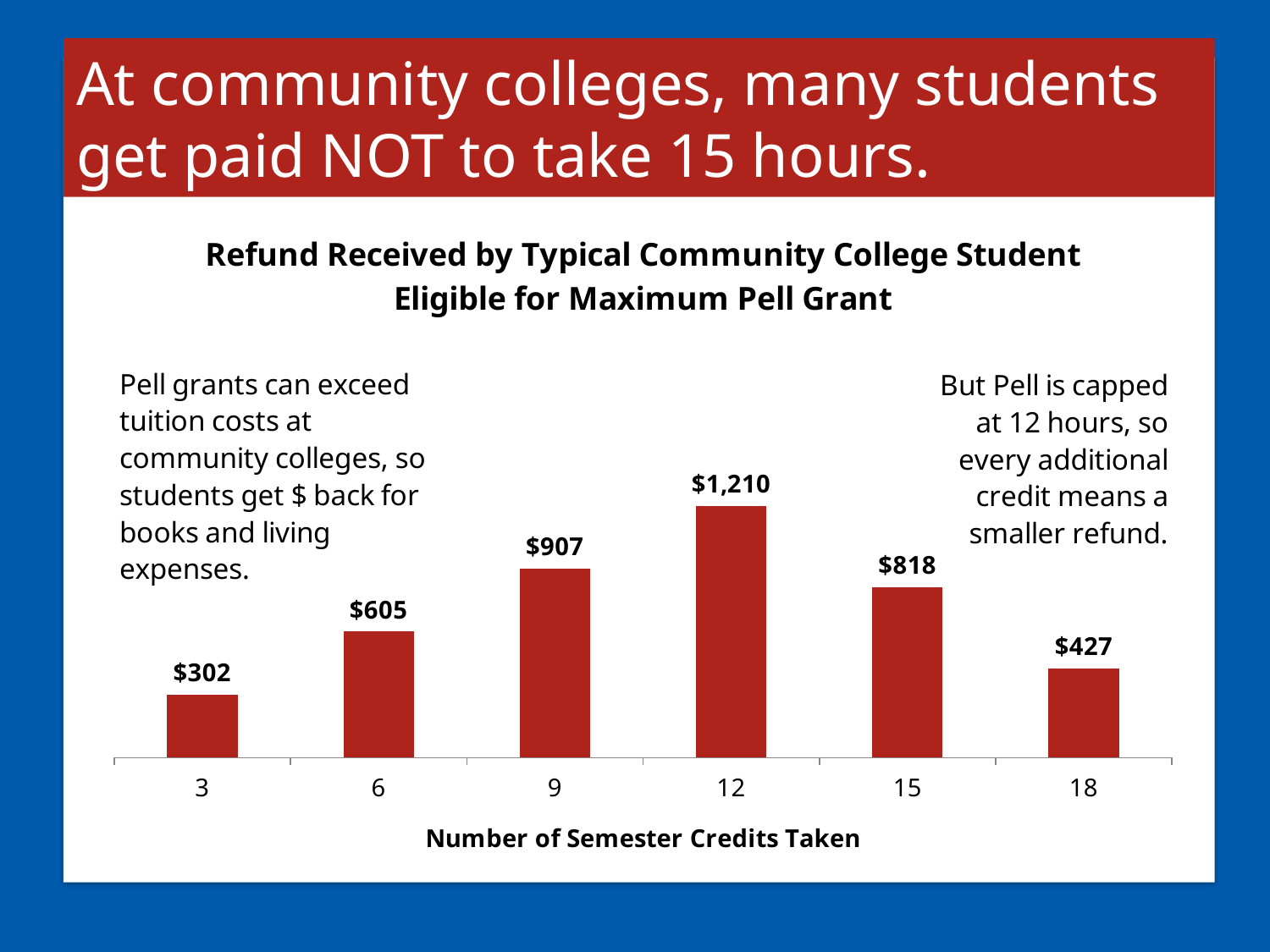
What is the refund received for 12 semester credits taken? $1,210 Which number of semester credits has the highest refund? 12 What is the label of the x axis? Number of Semester Credits Taken What kind of chart is shown on the slide? Bar chart What is the refund received for 18 semester credits taken? $427 What is the refund received for 3 semester credits taken? $302 How many credit-hour categories are shown on the x axis? 6 What is the difference between the refund for 12 credits and the refund for 15 credits? $392 Which has a larger refund, 9 credits or 15 credits? 9 credits Which number of semester credits has the lowest refund? 3 What is the refund received for 15 semester credits taken? $818 What is the difference between the refund for 9 credits and the refund for 6 credits? $302